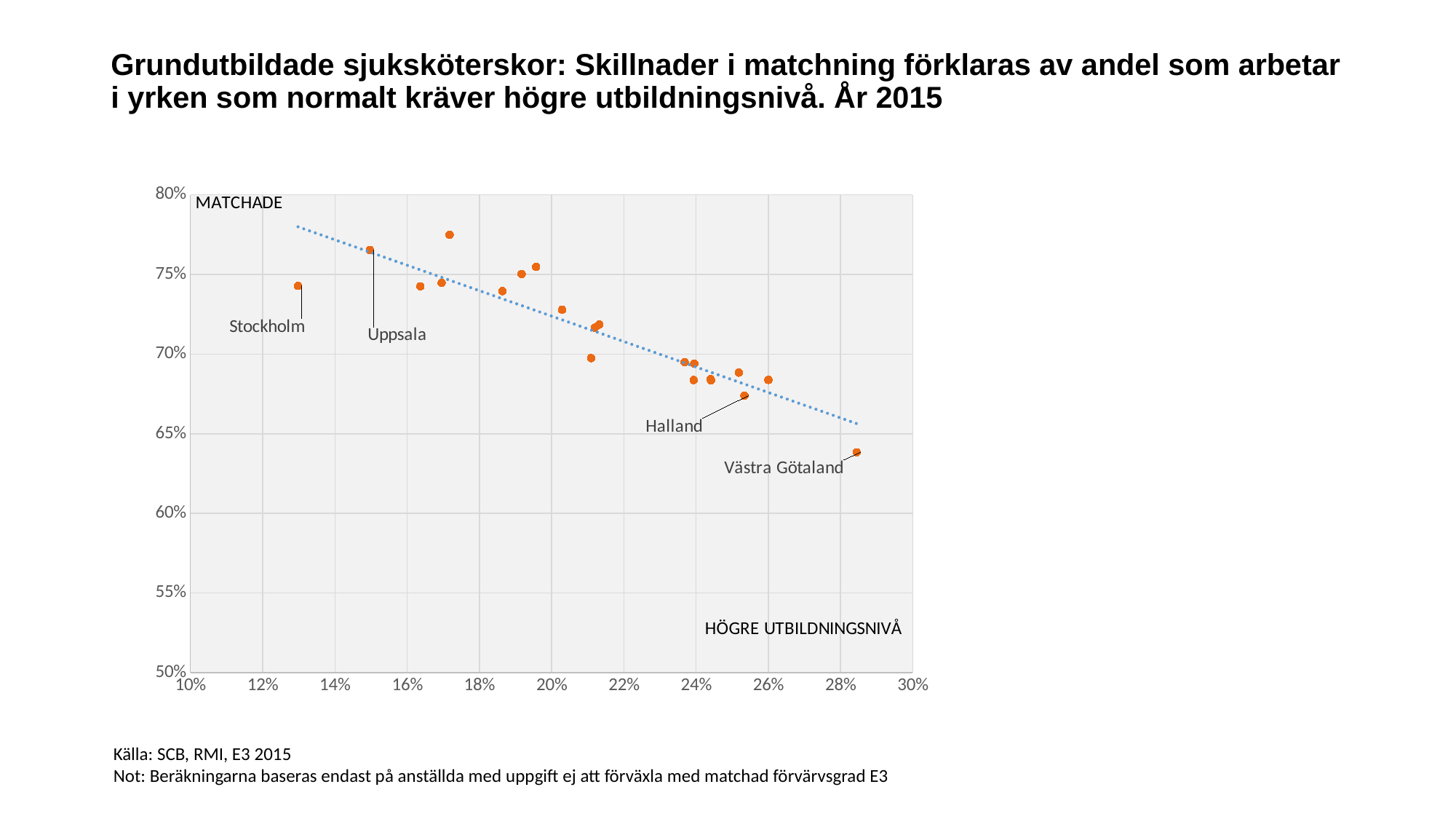
Which has the higher matched share (y value), Stockholm or Uppsala? Uppsala Is the matched share (y value) for Uppsala greater or less than 75%? greater Which has the higher matched share (y value), Halland or Västra Götaland? Halland Is the matched share (y value) for Halland greater or less than 65%? greater Is the matched share (y value) for Västra Götaland greater or less than 65%? less What kind of chart is shown on the slide? scatter chart What label is shown on the vertical axis of the chart? MATCHADE Do the plotted values for matched share (MATCHADE) rise or fall as the share in higher-education occupations increases along the x axis? fall Of the four labelled points, which has the lowest matched share (y value)? Västra Götaland